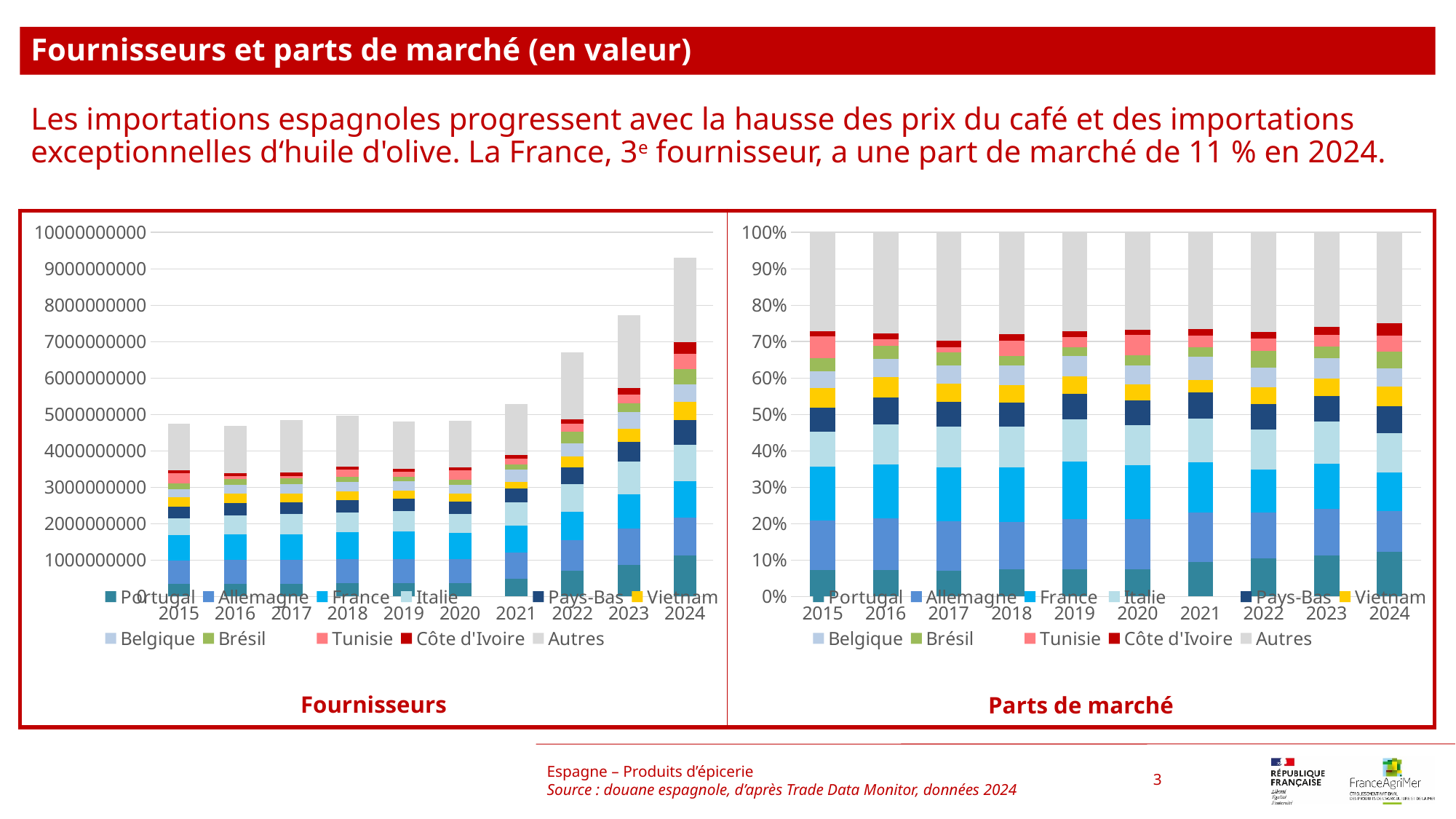
In the 'Fournisseurs' chart, is the total for 2023 greater or less than 7000000000? greater In the 'Fournisseurs' chart, is the total for 2015 greater or less than 5000000000? less In the 'Fournisseurs' chart, is the total for 2024 greater or less than 9000000000? greater What is the title of the chart on the right of the slide? Parts de marché How many series does the legend of the 'Parts de marché' chart list? 11 In the 'Fournisseurs' chart, do the total bars rise or fall from 2021 to 2024? rise How many years are shown on the x axis of the 'Fournisseurs' chart? 10 What kind of chart is the 'Fournisseurs' chart on the left? stacked bar chart In the 'Fournisseurs' chart, which total bar is larger, 2024 or 2015? 2024 In the 'Fournisseurs' chart, which year has the highest total bar? 2024 In the 'Parts de marché' chart, which series forms the bottom segment of each bar? Portugal In the 'Parts de marché' chart, what value does every stacked bar reach at the top? 100%